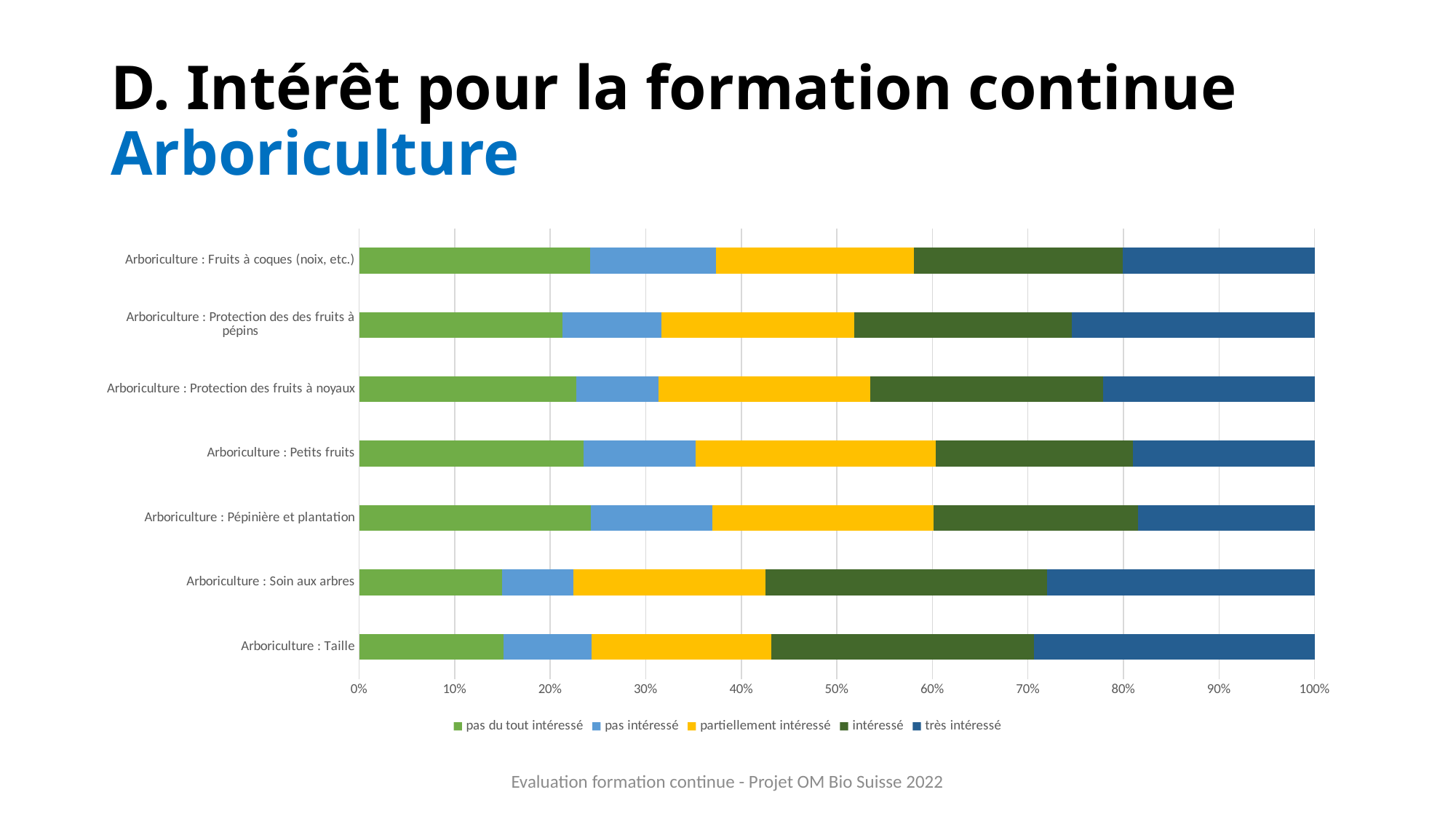
Which category is listed at the bottom of the chart? Arboriculture : Taille How many categories (bars) does the chart show? 7 Is the 'pas du tout intéressé' share for 'Arboriculture : Fruits à coques (noix, etc.)' greater or less than 20%? greater What kind of chart is shown on the slide? Stacked bar chart How many series does the legend list? 5 Is the 'très intéressé' share for 'Arboriculture : Taille' greater or less than 20%? greater Is the 'pas du tout intéressé' share for 'Arboriculture : Soin aux arbres' greater or less than 20%? less Which has a larger 'intéressé' share: 'Arboriculture : Soin aux arbres' or 'Arboriculture : Petits fruits'? Arboriculture : Soin aux arbres What is the total of the stacked bar for 'Arboriculture : Taille'? 100% Which legend entry is shown in yellow? partiellement intéressé Which has a larger 'pas du tout intéressé' share: 'Arboriculture : Fruits à coques (noix, etc.)' or 'Arboriculture : Taille'? Arboriculture : Fruits à coques (noix, etc.)